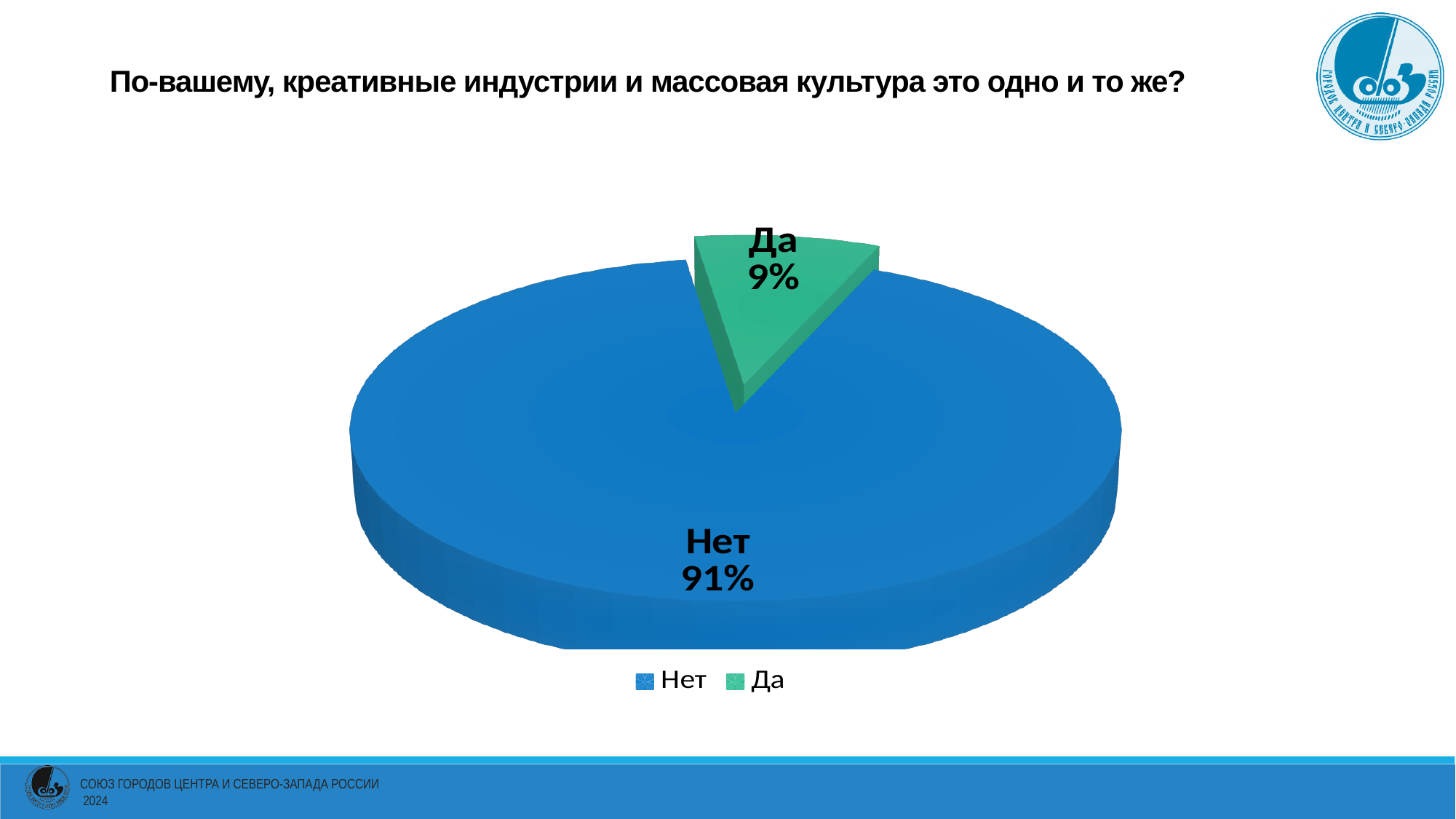
Which slice is the largest in the pie chart? Нет How many entries does the legend list? 2 Which is larger, the "Да" slice or the "Нет" slice? Нет How many slices does the pie chart have? 2 What colour is the "Да" slice? Green What share of the pie does the "Да" slice represent? 9% What is the difference in percentage points between the "Нет" and "Да" slices? 82 Which slice is the smallest in the pie chart? Да What question is posed in the slide title above the chart? По-вашему, креативные индустрии и массовая культура это одно и то же? What kind of chart is shown on the slide? Pie chart What share of the pie does the "Нет" slice represent? 91%